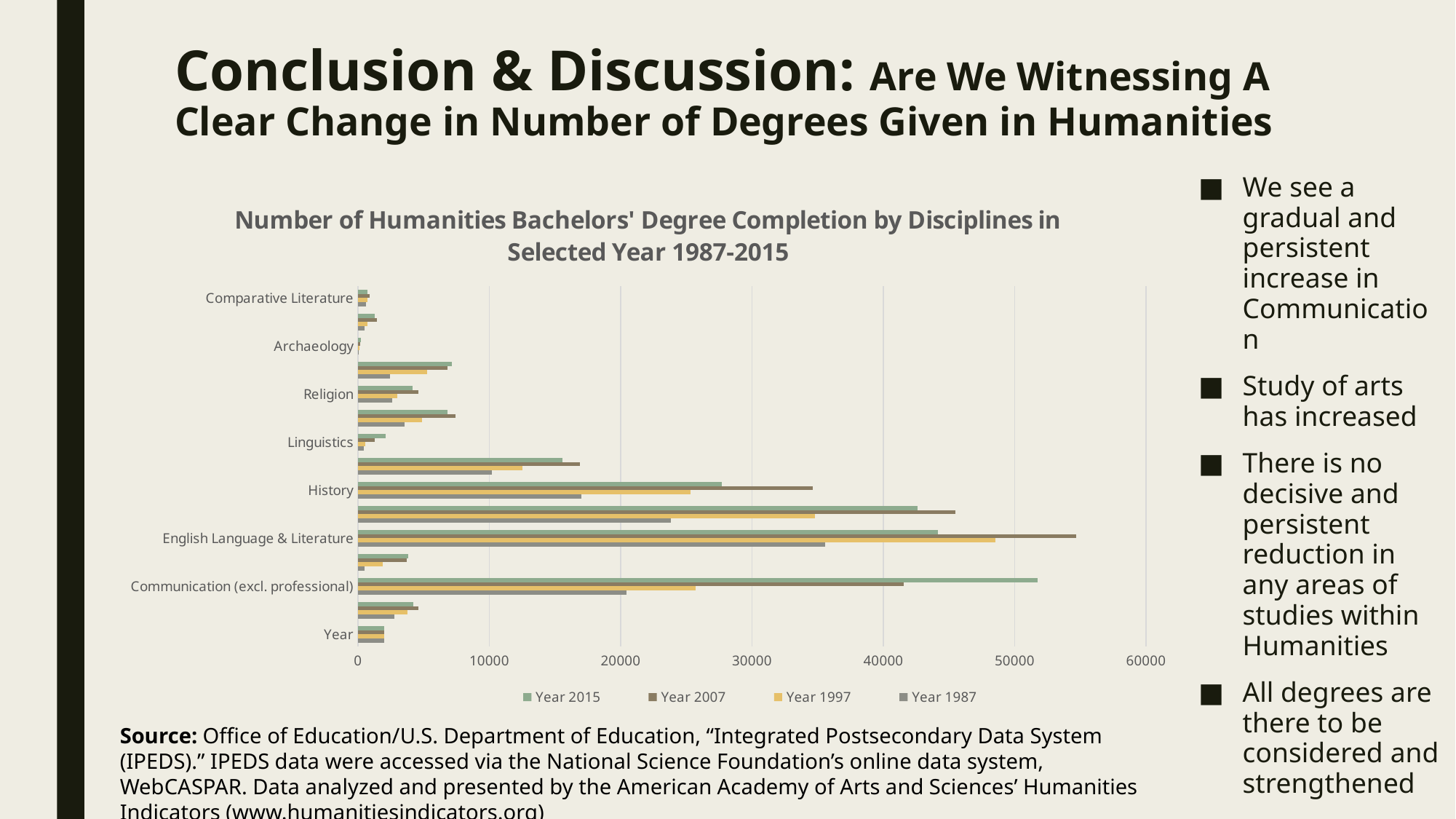
For Communication (excl. professional), which is larger: the Year 2015 value or the Year 2007 value? Year 2015 Is the Year 2007 value for History greater or less than 30000? greater Is the Year 1987 value for Communication (excl. professional) greater or less than 30000? less Which year series has the longest bar for Communication (excl. professional)? Year 2015 Is the Year 2007 value for English Language & Literature greater or less than 50000? greater Which has the larger Year 2015 value: Communication (excl. professional) or English Language & Literature? Communication (excl. professional) How many series does the legend list? 4 What is the title of the chart? Number of Humanities Bachelors' Degree Completion by Disciplines in Selected Year 1987-2015 What kind of chart is shown on the slide? bar chart For History, which is larger: the Year 2007 value or the Year 1987 value? Year 2007 Which year series has the longest bar for English Language & Literature? Year 2007